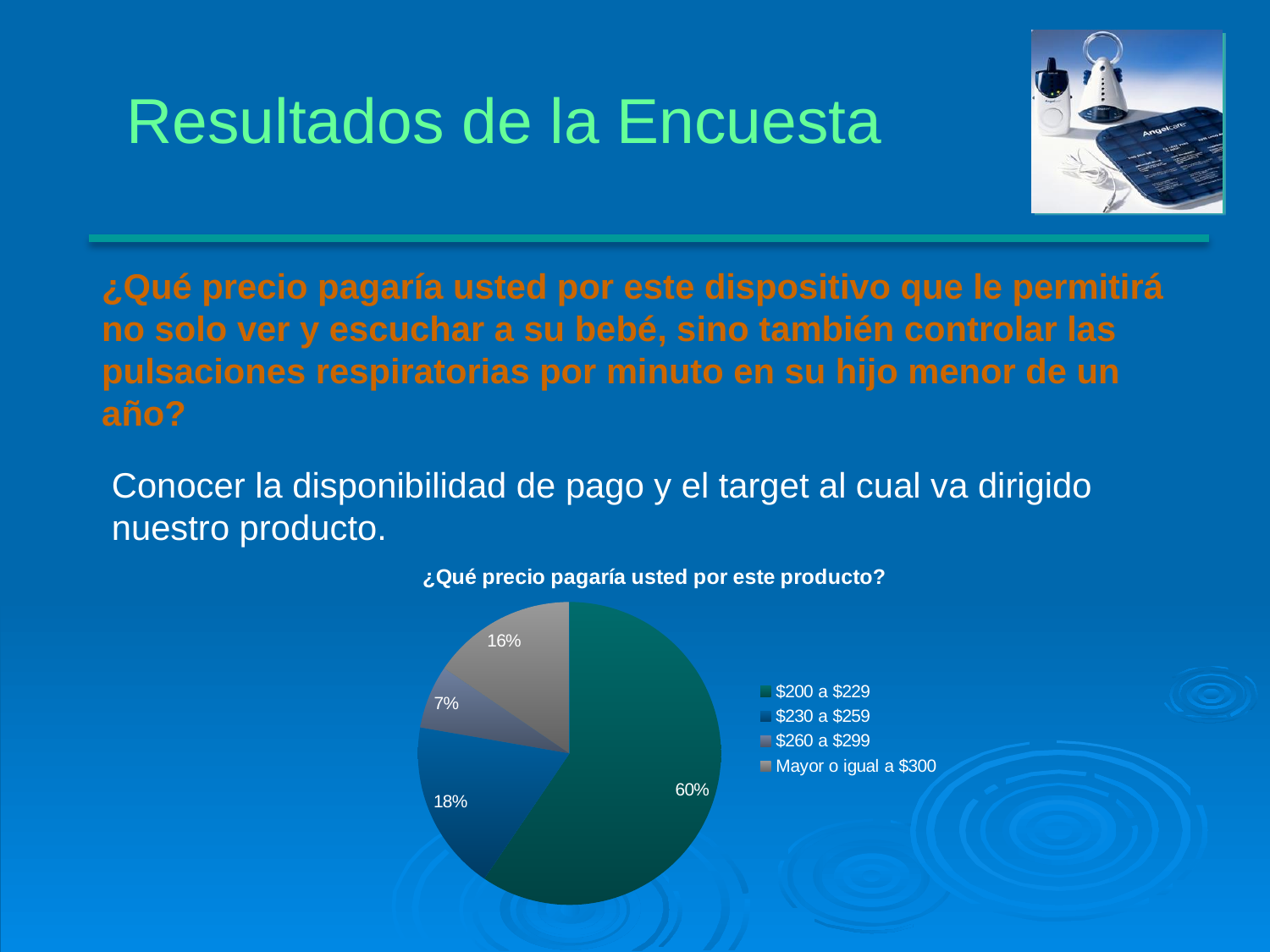
What percentage of respondents chose $230 a $259? 18% What is the difference in percentage points between $200 a $229 and $230 a $259? 42 Which is larger, the share for $230 a $259 or the share for Mayor o igual a $300? $230 a $259 How many price categories does the legend list? 4 What is the title of the chart? ¿Qué precio pagaría usted por este producto? Which price range has the smallest share of the pie? $260 a $299 What type of chart is shown on the slide? pie chart What is the combined share of $260 a $299 and Mayor o igual a $300? 23% What percentage of respondents chose $200 a $229? 60% What percentage of respondents chose $260 a $299? 7% Which price range has the largest share of the pie? $200 a $229 What percentage of respondents chose Mayor o igual a $300? 16%